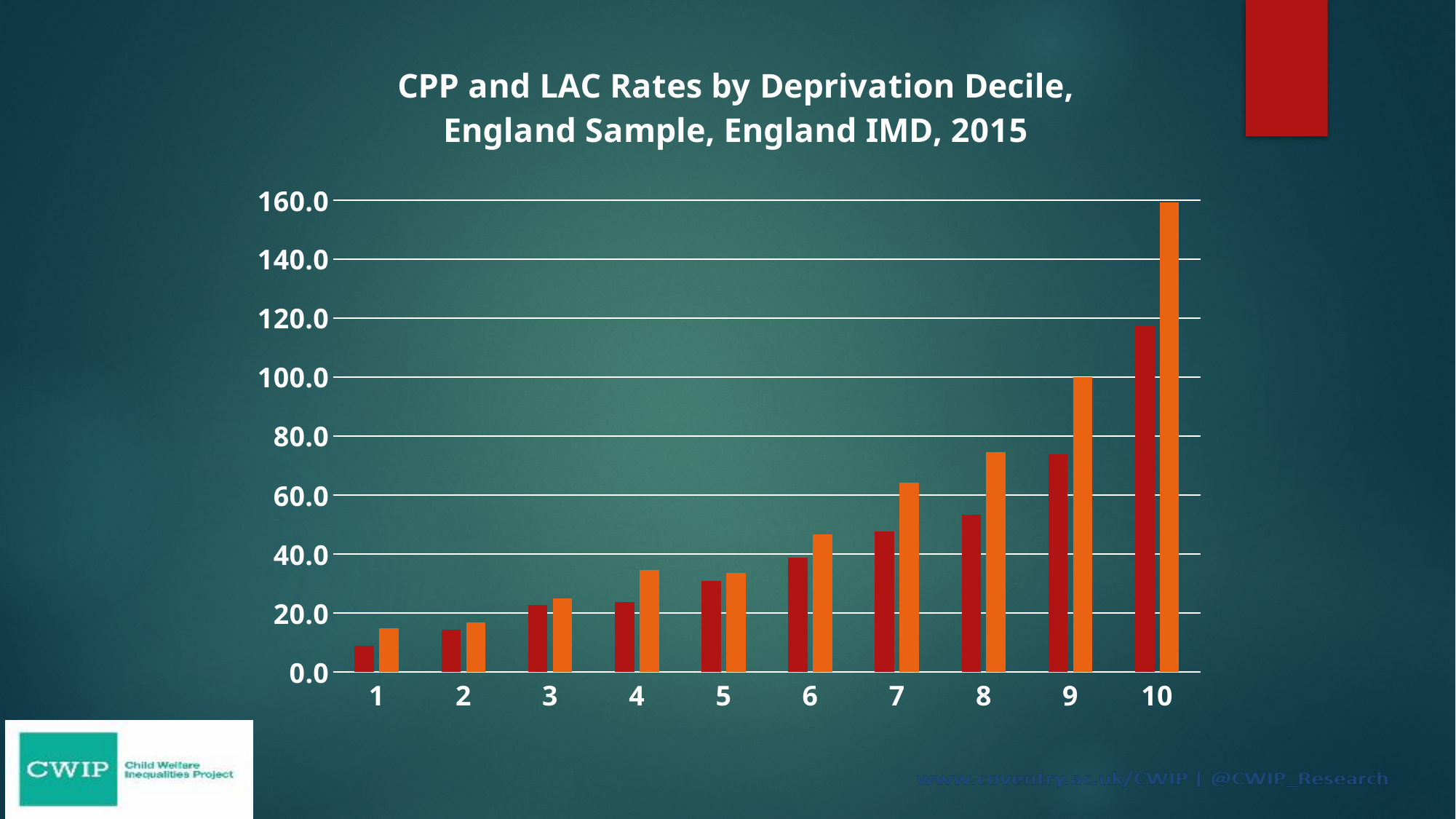
Which is taller, the red bar for decile 9 or the red bar for decile 10? decile 10 Is the red bar for decile 10 greater or less than 100? greater Is the orange bar for decile 8 greater or less than 80? less Which decile has the tallest orange bar? 10 How many deprivation deciles are shown on the x axis? 10 Which decile has the shortest red bar? 1 What kind of chart is shown on the slide? bar chart What is the title of the chart? CPP and LAC Rates by Deprivation Decile, England Sample, England IMD, 2015 Is the red bar for decile 1 greater or less than 20? less Do the bar values generally rise or fall as the decile number increases from 1 to 10? rise For decile 10, which bar is taller, the red bar or the orange bar? orange bar